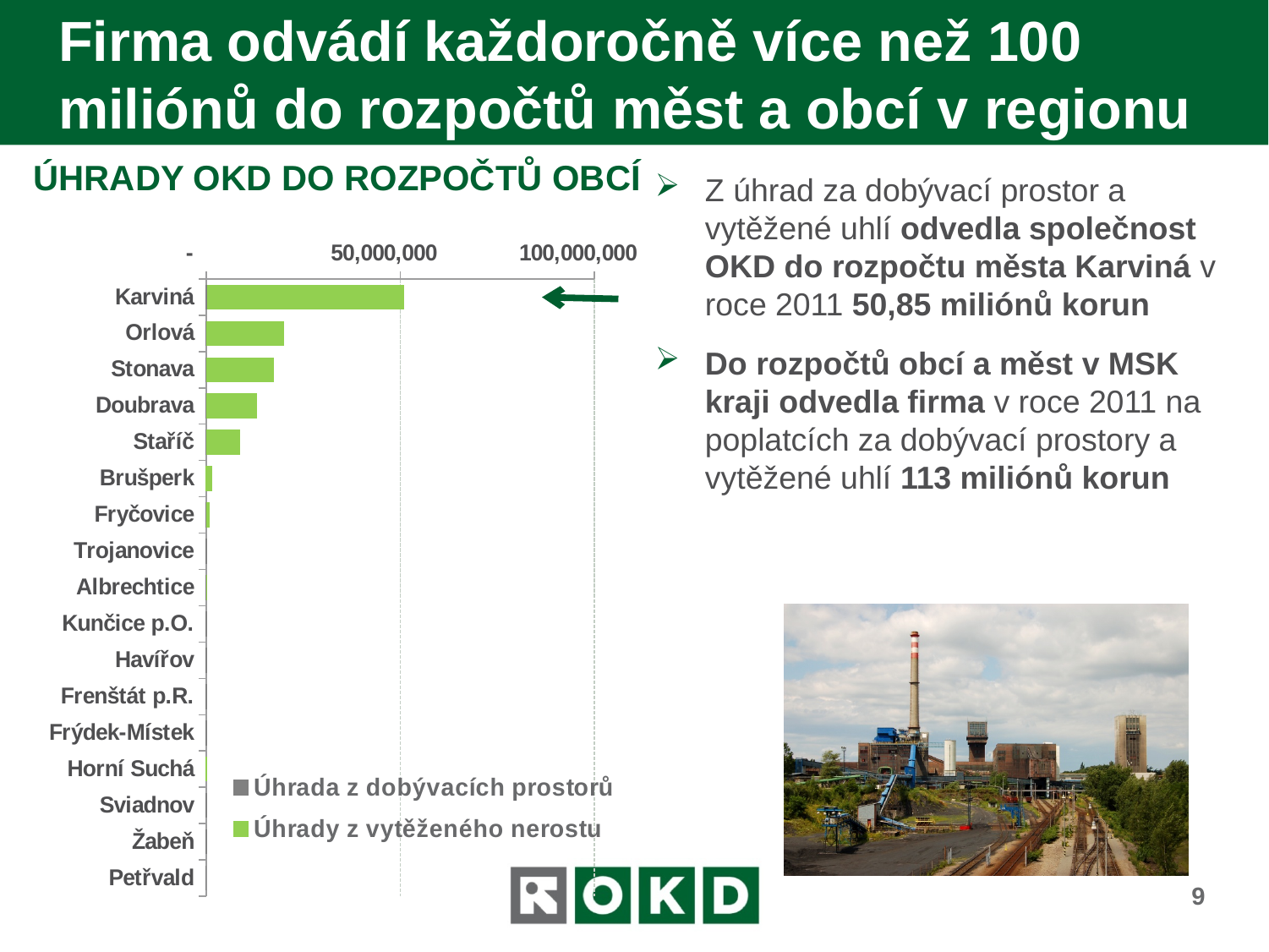
Is the value for Orlová greater or less than 50,000,000? less What kind of chart is shown on the slide? bar chart How many municipalities (categories) are listed on the chart's vertical axis? 17 Is the value for Karviná greater or less than 100,000,000? less Which has the larger value, Orlová or Staříč? Orlová Which has the larger value, Karviná or Orlová? Karviná Which has the larger value, Doubrava or Brušperk? Doubrava What is the title of the chart? ÚHRADY OKD DO ROZPOČTŮ OBCÍ Which legend entry is shown in green? Úhrady z vytěženého nerostu Which municipality has the highest value in the chart? Karviná How many series does the chart legend list? 2